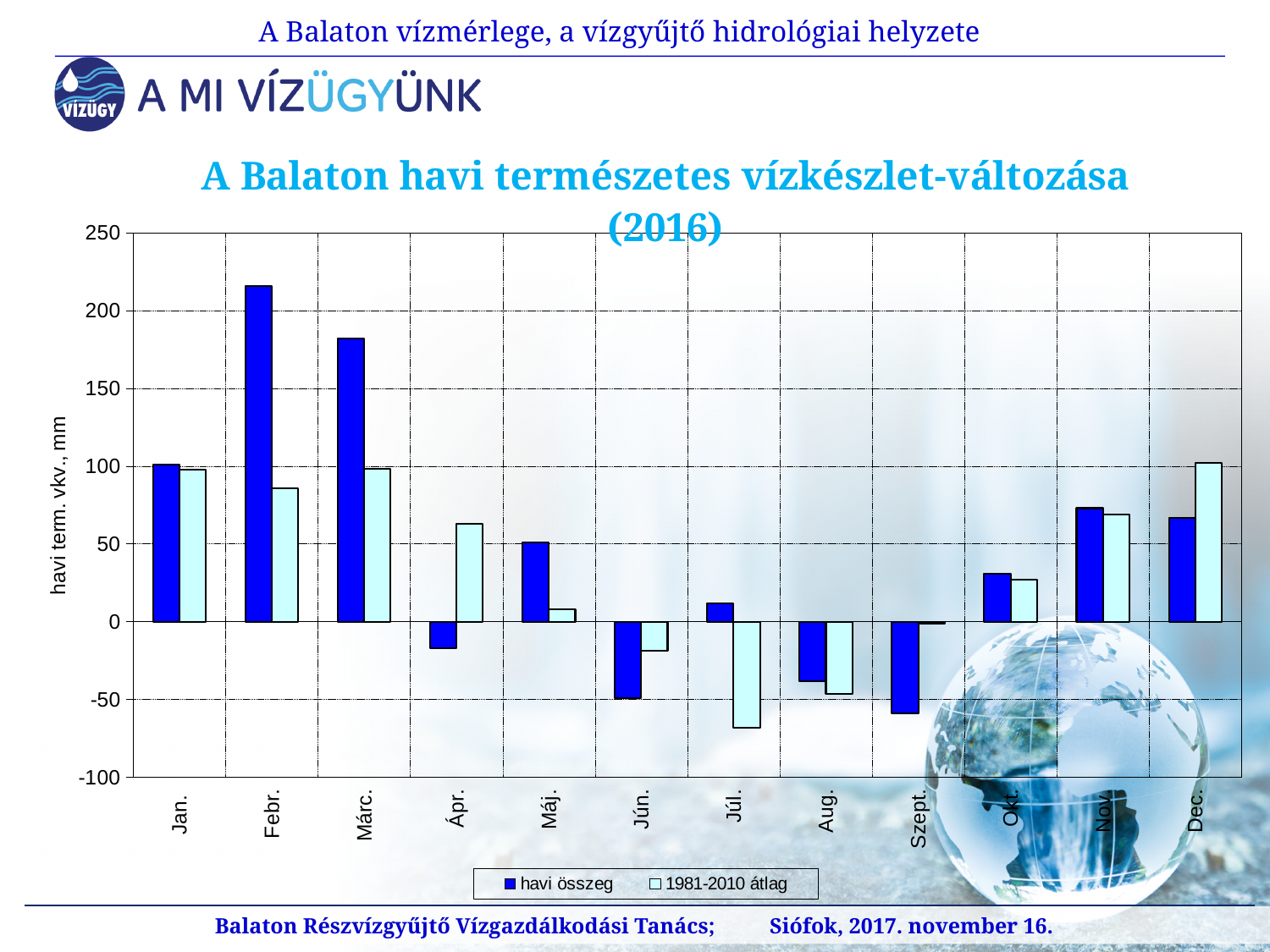
For Dec., which series has the larger value: 'havi összeg' or '1981-2010 átlag'? 1981-2010 átlag What kind of chart is shown on the slide? bar chart Which month has the highest value for the 'havi összeg' series? Febr. Is the 'havi összeg' value for Febr. greater or less than 200? greater Which month has the lowest value for the 'havi összeg' series? Szept. What is the label of the vertical axis? havi term. vkv., mm Is the '1981-2010 átlag' value for Júl. greater or less than -50? less How many months (categories) are shown on the x axis? 12 How many series does the legend list? 2 Is the 'havi összeg' value for Márc. greater or less than 150? greater Which month has the lowest value for the '1981-2010 átlag' series? Júl. For Ápr., which series has the larger value: 'havi összeg' or '1981-2010 átlag'? 1981-2010 átlag